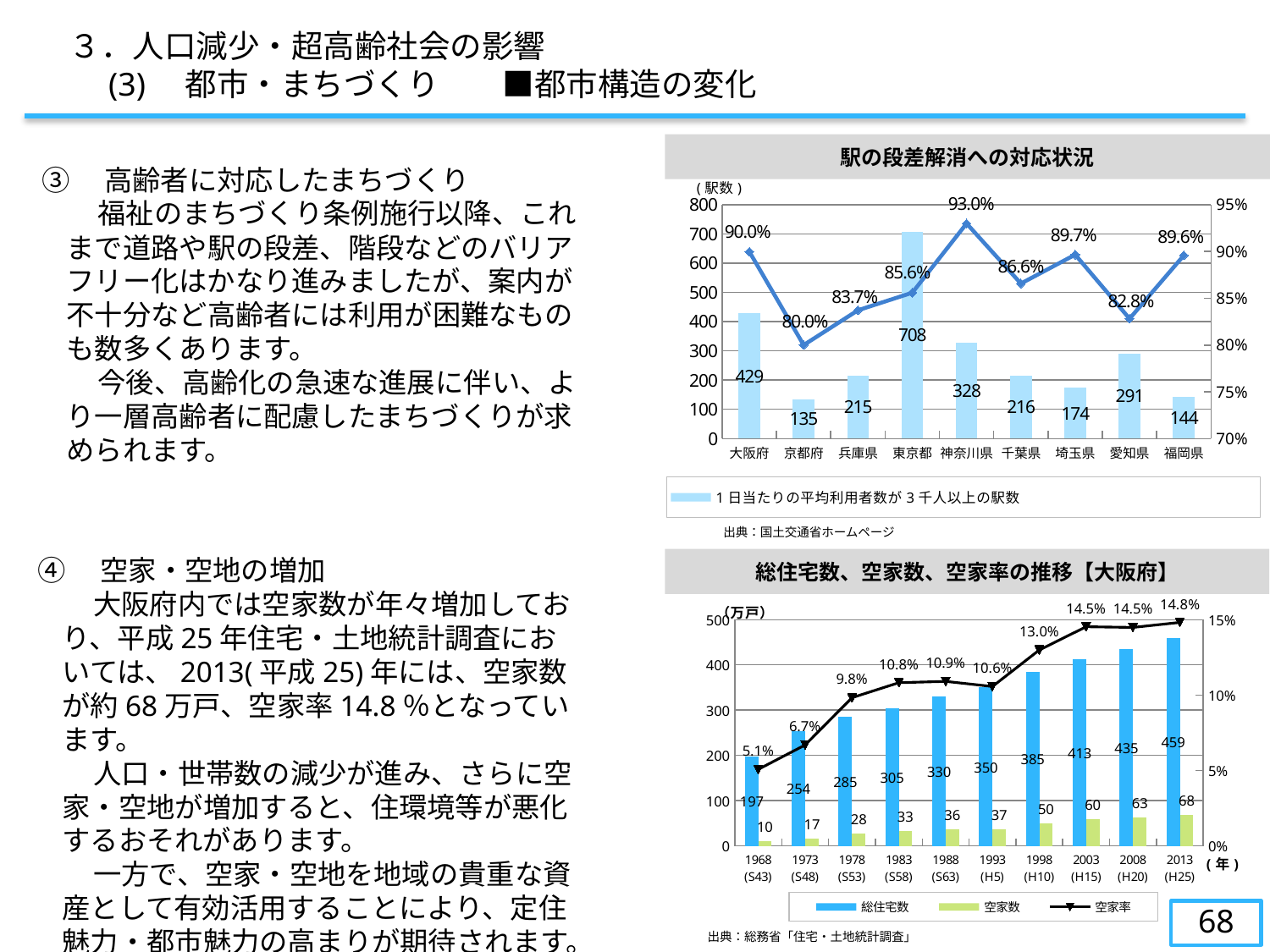
In the chart titled 総住宅数、空家数、空家率の推移【大阪府】, what is the 総住宅数 value for 1968? 197 In the chart titled 総住宅数、空家数、空家率の推移【大阪府】, what is the 空家率 for 2013? 14.8% In the chart titled 総住宅数、空家数、空家率の推移【大阪府】, does the 総住宅数 rise or fall from 1968 to 2013? rise In the chart titled 総住宅数、空家数、空家率の推移【大阪府】, which is larger, the 空家数 for 1998 or for 1993? 1998 In the chart titled 総住宅数、空家数、空家率の推移【大阪府】, how many series does the legend list? 3 In the chart titled 駅の段差解消への対応状況, what is the difference in station count between 大阪府 and 京都府? 294 In the chart titled 駅の段差解消への対応状況, how many stations are shown for 東京都? 708 In the chart titled 駅の段差解消への対応状況, how many prefectures are shown on the x axis? 9 In the chart titled 総住宅数、空家数、空家率の推移【大阪府】, what is the difference in 空家数 between 2013 and 1968? 58 In the chart titled 駅の段差解消への対応状況, what is the percentage value shown for 神奈川県? 93.0% In the chart titled 駅の段差解消への対応状況, which prefecture has the lowest percentage on the line? 京都府 In the chart titled 駅の段差解消への対応状況, which prefecture has the highest number of stations? 東京都